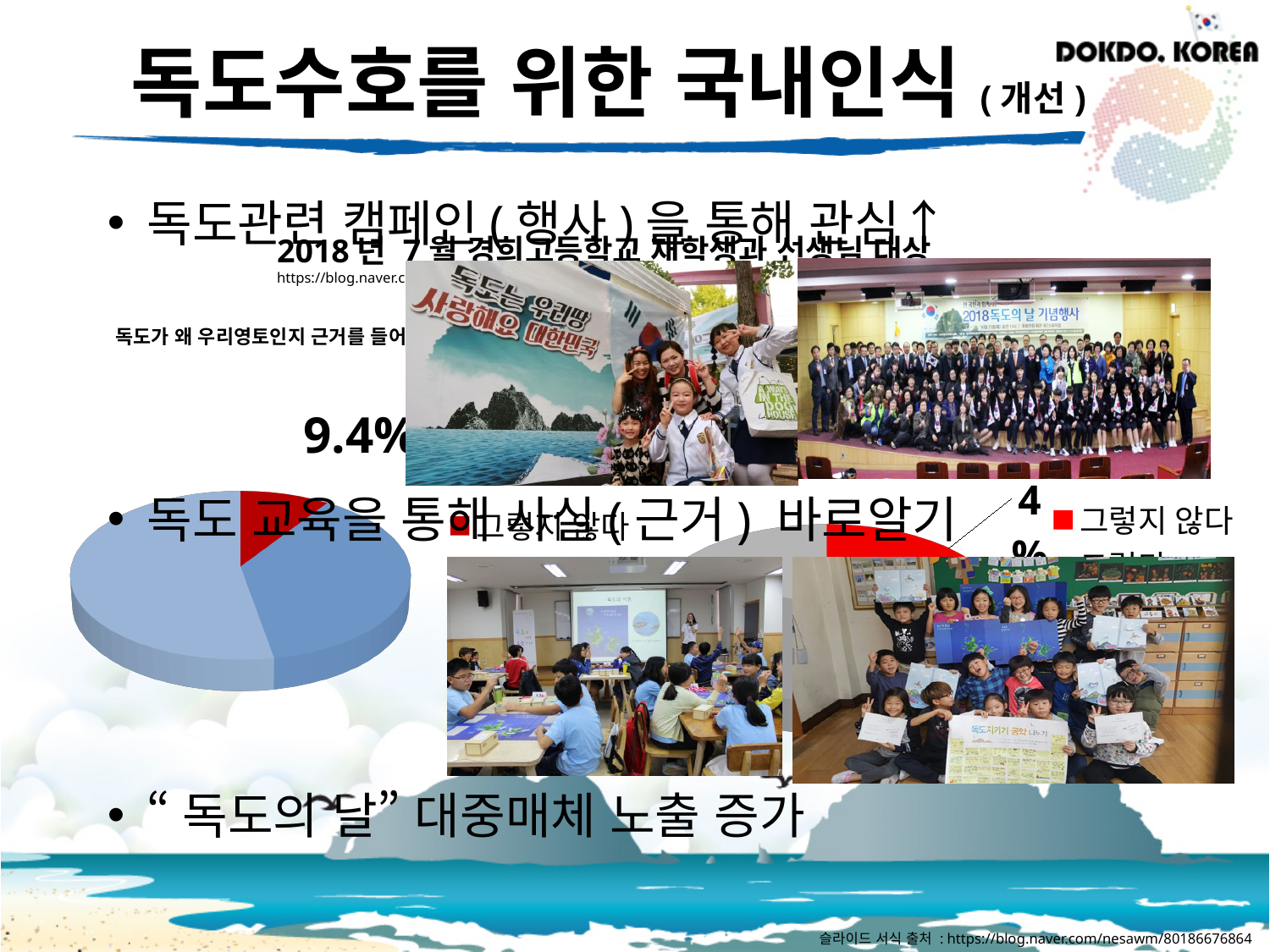
In the pie chart, is the "그렇지 않다" slice larger or smaller than the light blue slice? smaller In the pie chart, what colour is the slice for "그렇지 않다"? red In the pie chart, which category has the smallest slice? 그렇지 않다 What kind of chart is shown on the slide? pie chart